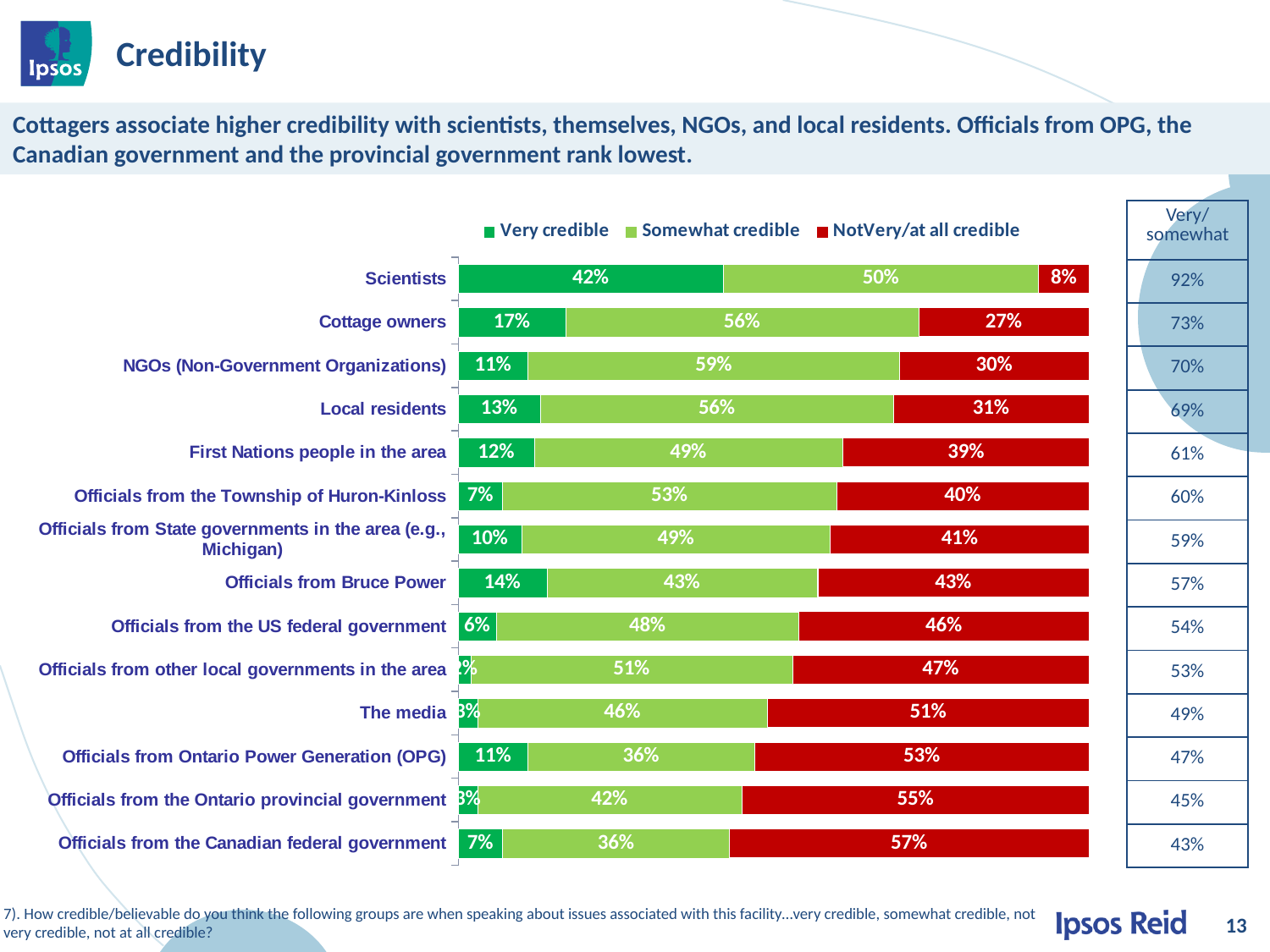
What is the combined 'Very credible' and 'Somewhat credible' total for First Nations people in the area? 61% What is the 'NotVery/at all credible' value for Officials from the Canadian federal government? 57% What is the 'Very credible' value for Scientists? 42% What is the difference between the 'NotVery/at all credible' values for Officials from Ontario Power Generation (OPG) and Cottage owners? 26% Which is larger: the 'Very credible' value for Officials from Bruce Power or for Local residents? Officials from Bruce Power What colour represents the 'NotVery/at all credible' series? red What is the 'Somewhat credible' value for NGOs (Non-Government Organizations)? 59% How many groups (categories) are plotted on the chart? 14 What kind of chart is shown on the slide? stacked bar chart How many series does the legend list? 3 Which group has the lowest 'NotVery/at all credible' value? Scientists Which group has the highest 'Very credible' value? Scientists